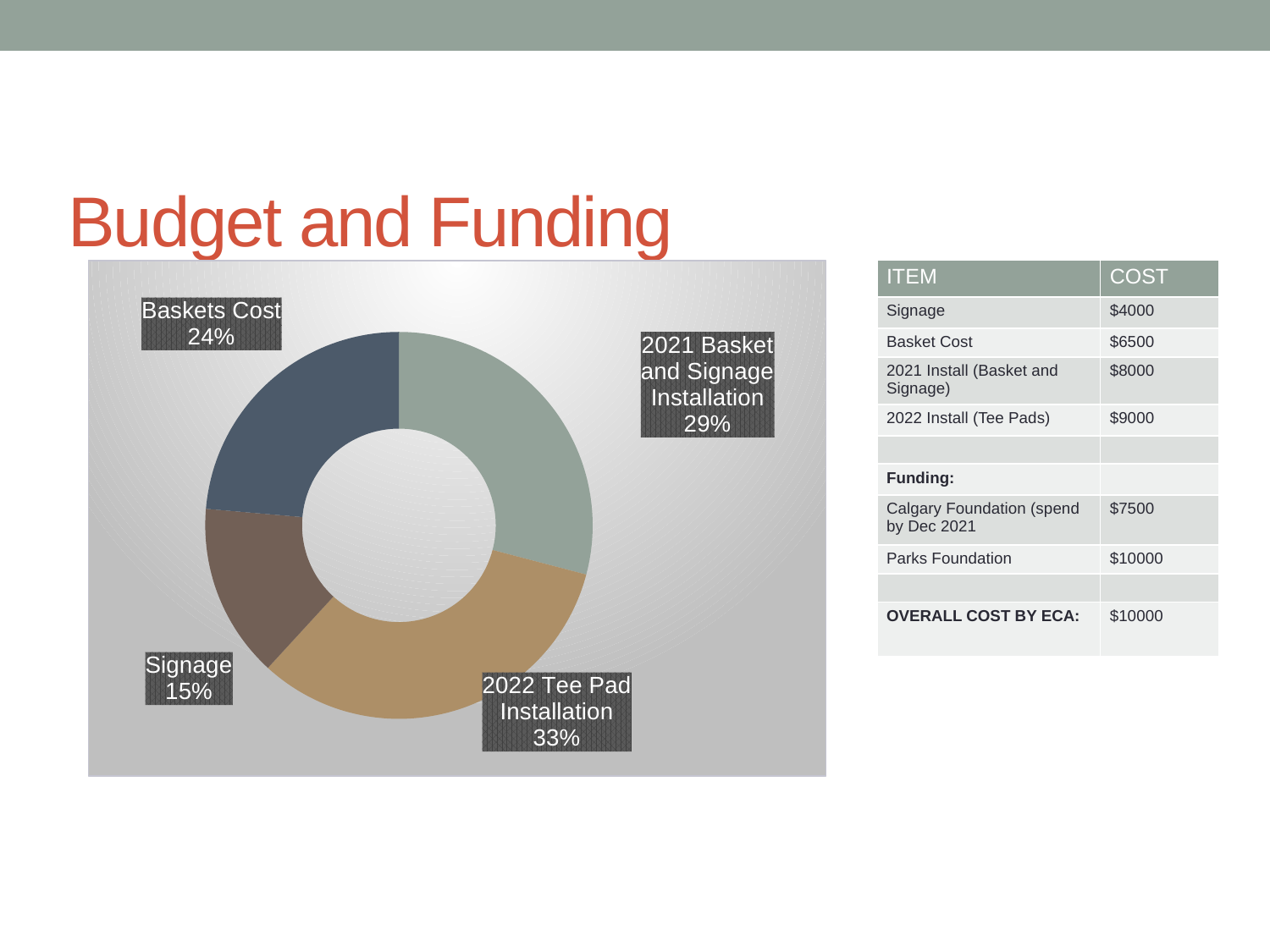
Which category has the smallest share of the chart? Signage What share of the chart does Signage represent? 15% What is the difference in percentage points between 2022 Tee Pad Installation and Signage? 18 What share of the chart does Baskets Cost represent? 24% What kind of chart is shown on the slide? Doughnut chart How many categories are shown in the chart? 4 What share of the chart does 2021 Basket and Signage Installation represent? 29% What is the combined share of Baskets Cost and Signage? 39% What is the difference in percentage points between 2021 Basket and Signage Installation and Baskets Cost? 5 Which is larger, the share for Baskets Cost or the share for Signage? Baskets Cost Which category has the largest share of the chart? 2022 Tee Pad Installation What share of the chart does 2022 Tee Pad Installation represent? 33%